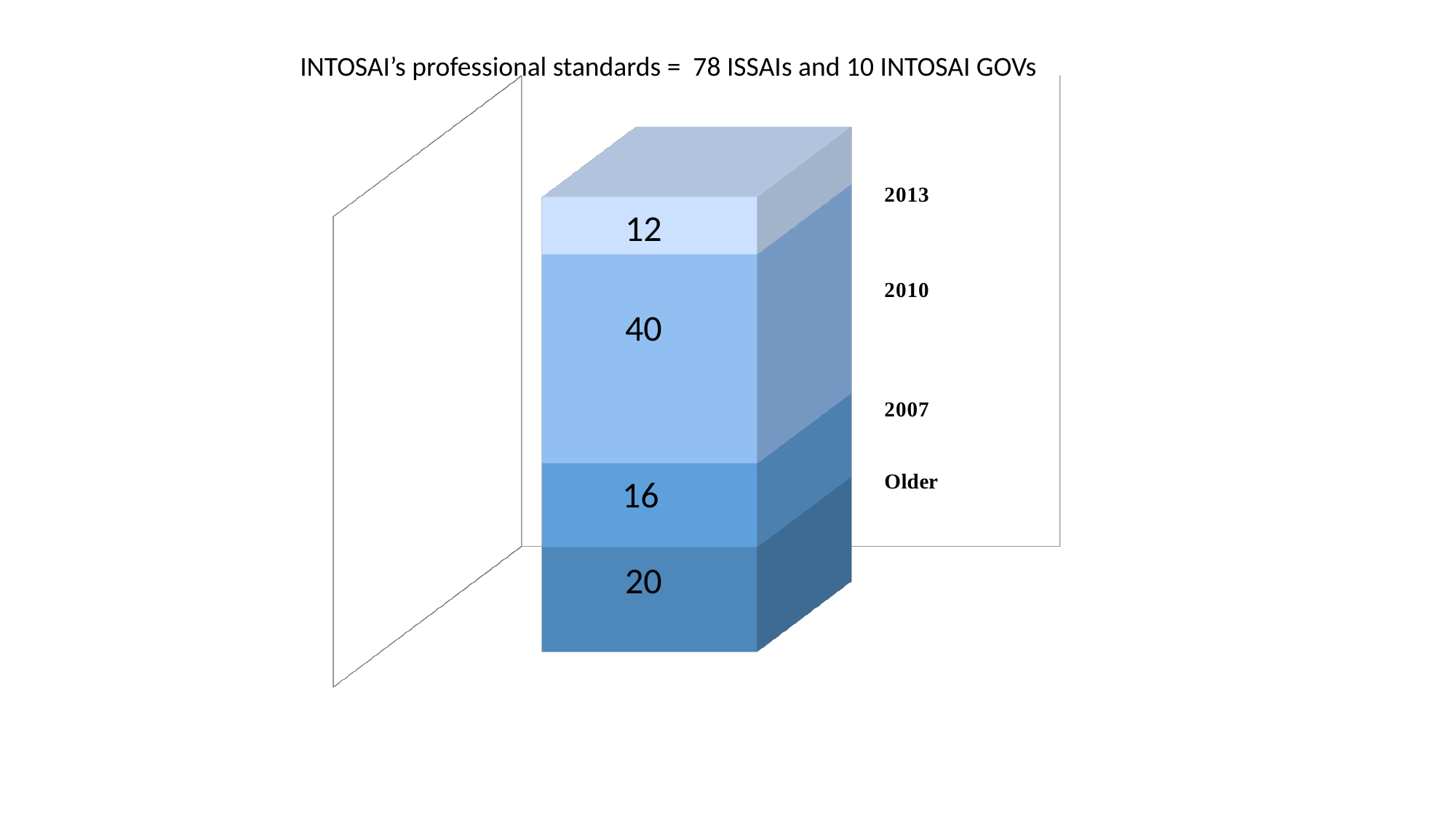
Which segment of the stacked bar has the largest value? 2010 What is the value of the Older segment of the stacked bar? 20 What is the total of all segments in the stacked bar? 88 What is the title of the chart? INTOSAI's professional standards = 78 ISSAIs and 10 INTOSAI GOVs How many segments make up the stacked bar? 4 What kind of chart is shown on the slide? stacked bar chart Which segment of the stacked bar has the smallest value? 2013 What is the value of the 2013 segment of the stacked bar? 12 Which is larger, the Older segment or the 2007 segment? Older What is the value of the 2007 segment of the stacked bar? 16 What is the value of the 2010 segment of the stacked bar? 40 What is the difference between the 2010 segment and the 2007 segment? 24